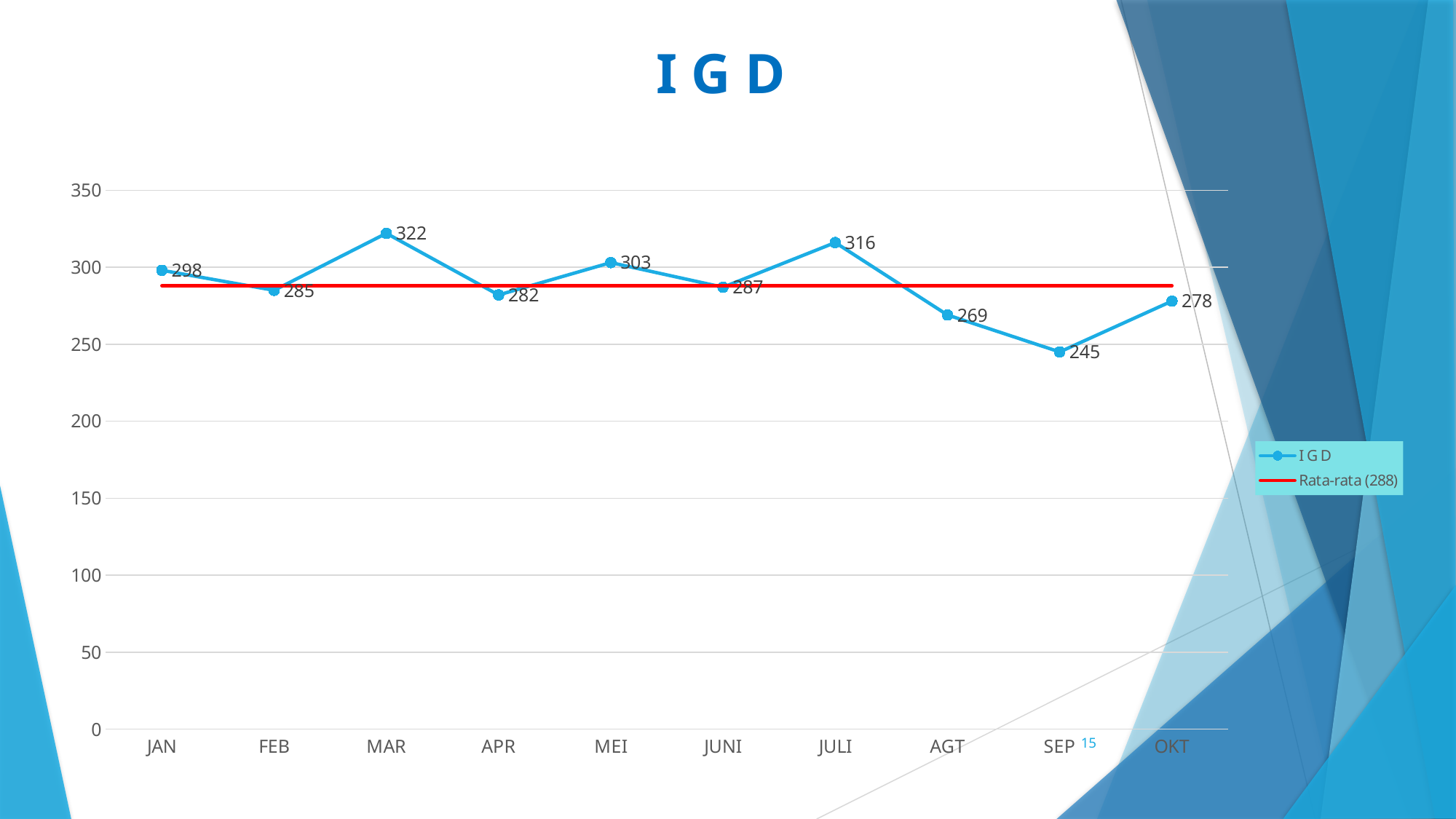
What is the difference between the IGD values for MAR and SEP? 77 What value does the legend give for the Rata-rata line? 288 Is the IGD value for OKT greater or less than 300? less What is the IGD value for MAR? 322 What kind of chart is shown on the slide? line chart Which month has the lowest IGD value? SEP Which month has the highest IGD value? MAR How many series does the legend list? 2 What is the IGD value for JUNI? 287 Which month has a higher IGD value, JULI or AGT? JULI What is the IGD value for SEP? 245 How many months are plotted on the x axis? 10